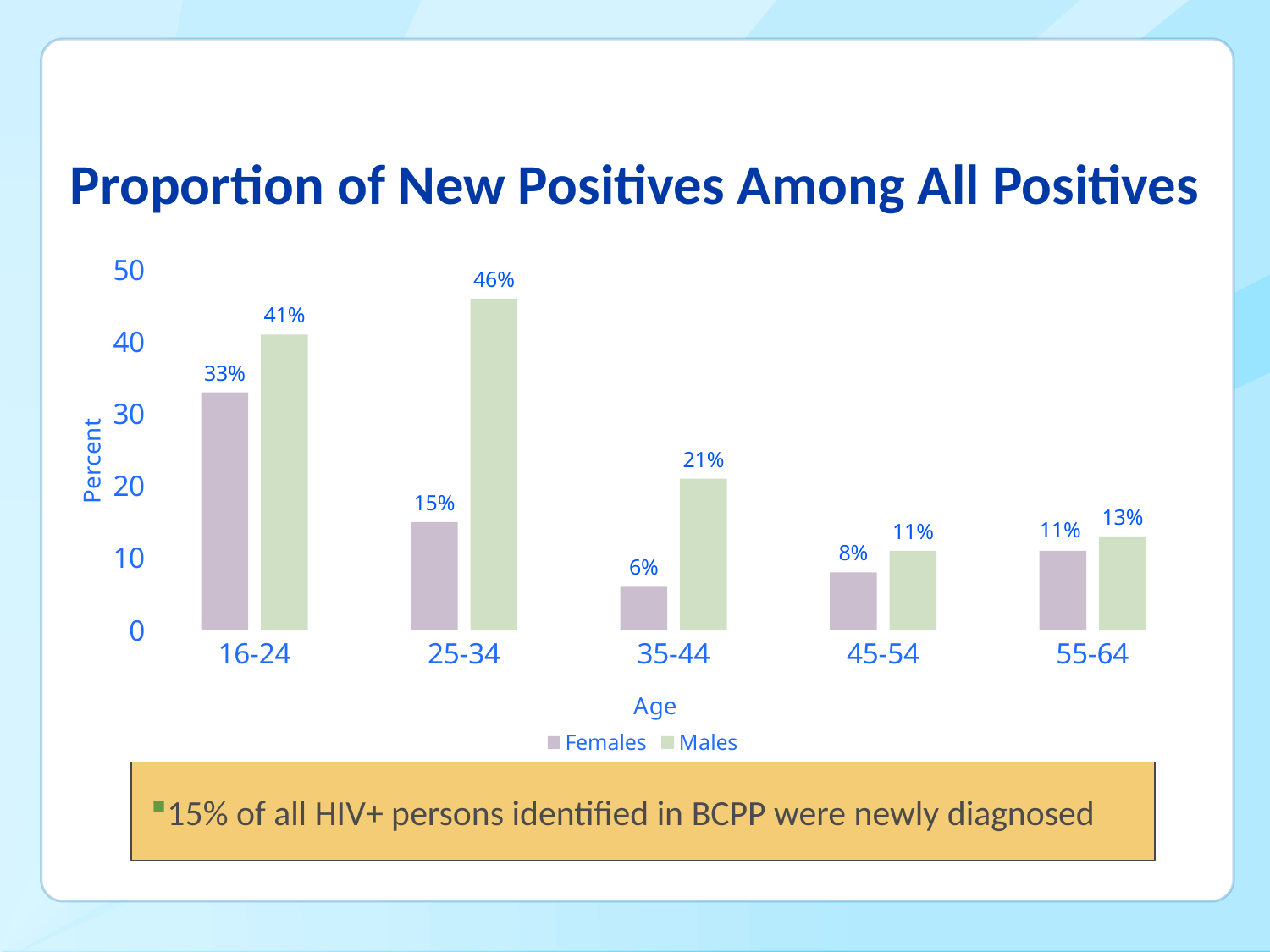
Which is larger: the Females value for 16-24 or the Females value for 25-34? Females value for 16-24 What is the value for Females in the 16-24 age group? 33% Which age group has the lowest value for Females? 35-44 Which age group has the highest value for Males? 25-34 What is the difference between the Males and Females values in the 25-34 age group? 31% What kind of chart is shown on the slide? Bar chart What is the title of the chart? Proportion of New Positives Among All Positives What is the value for Males in the 25-34 age group? 46% How many series does the legend list? 2 Do the Males values generally rise or fall from the 25-34 age group to the 55-64 age group? Fall How many age groups are shown on the x axis? 5 What is the value for Females in the 35-44 age group? 6%